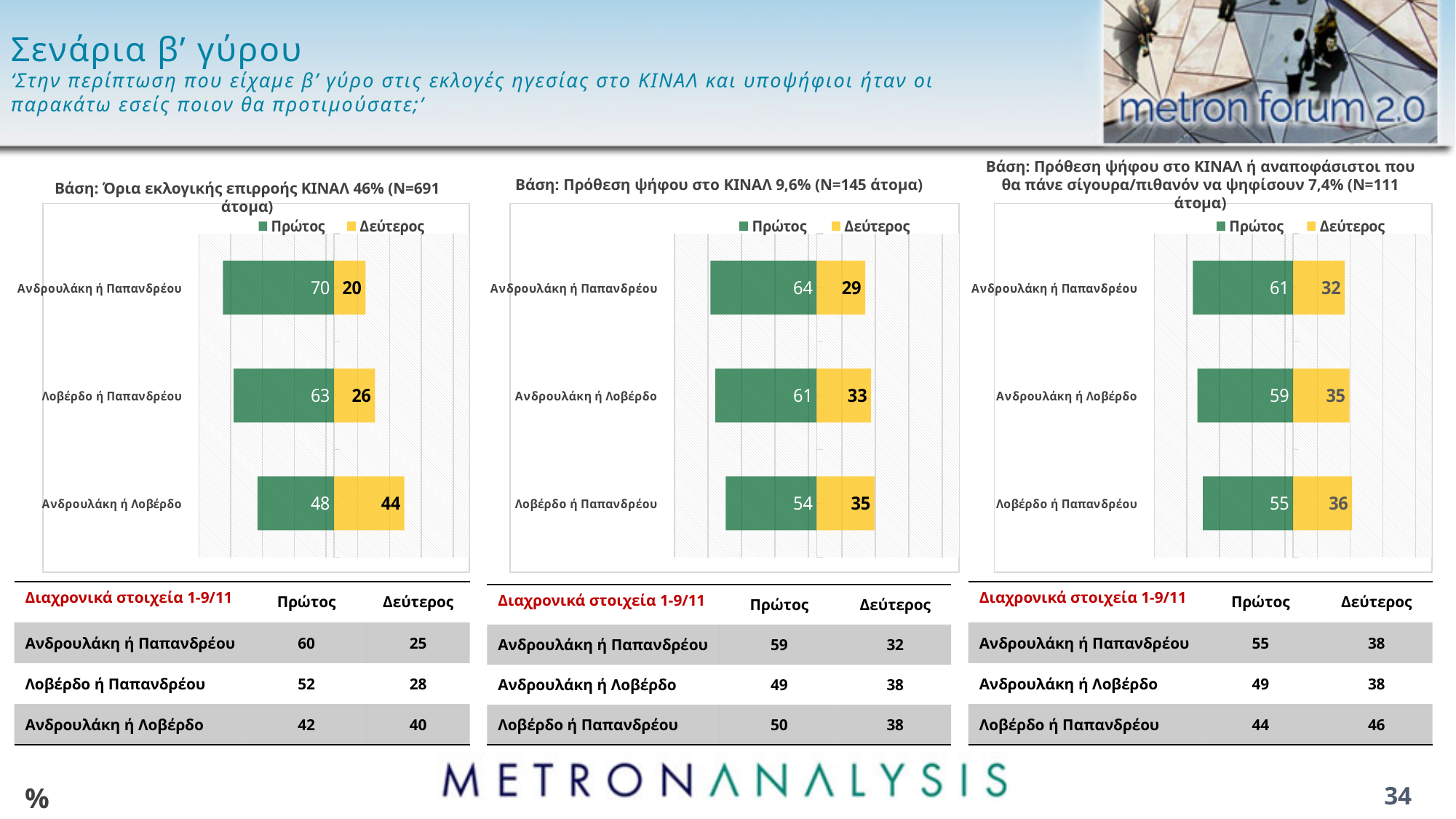
In the left chart (Βάση: Όρια εκλογικής επιρροής ΚΙΝΑΛ 46%), what is the Δεύτερος value for Ανδρουλάκη ή Λοβέρδο? 44 In the right chart (Βάση: Πρόθεση ψήφου στο ΚΙΝΑΛ ή αναποφάσιστοι 7,4%), what is the Πρώτος value for Ανδρουλάκη ή Λοβέρδο? 59 How many series does the legend of the middle chart (Βάση: Πρόθεση ψήφου στο ΚΙΝΑΛ 9,6%) list? 2 In the right chart (Βάση: Πρόθεση ψήφου στο ΚΙΝΑΛ ή αναποφάσιστοι 7,4%), which is larger: the Δεύτερος value for Ανδρουλάκη ή Παπανδρέου or for Λοβέρδο ή Παπανδρέου? Λοβέρδο ή Παπανδρέου In the middle chart (Βάση: Πρόθεση ψήφου στο ΚΙΝΑΛ 9,6%), what is the Δεύτερος value for Ανδρουλάκη ή Λοβέρδο? 33 In the middle chart (Βάση: Πρόθεση ψήφου στο ΚΙΝΑΛ 9,6%), which category has the highest Πρώτος value? Ανδρουλάκη ή Παπανδρέου In the left chart (Βάση: Όρια εκλογικής επιρροής ΚΙΝΑΛ 46%), what is the difference between the Πρώτος and Δεύτερος values for Λοβέρδο ή Παπανδρέου? 37 In the right chart (Βάση: Πρόθεση ψήφου στο ΚΙΝΑΛ ή αναποφάσιστοι 7,4%), how many categories are shown? 3 In the left chart (Βάση: Όρια εκλογικής επιρροής ΚΙΝΑΛ 46%), which category has the lowest Πρώτος value? Ανδρουλάκη ή Λοβέρδο In the middle chart (Βάση: Πρόθεση ψήφου στο ΚΙΝΑΛ 9,6%), what is the total of the stacked bar for Λοβέρδο ή Παπανδρέου? 89 What kind of chart is the left chart (Βάση: Όρια εκλογικής επιρροής ΚΙΝΑΛ 46%)? Stacked horizontal bar chart In the left chart (Βάση: Όρια εκλογικής επιρροής ΚΙΝΑΛ 46%), what is the Πρώτος value for Ανδρουλάκη ή Παπανδρέου? 70